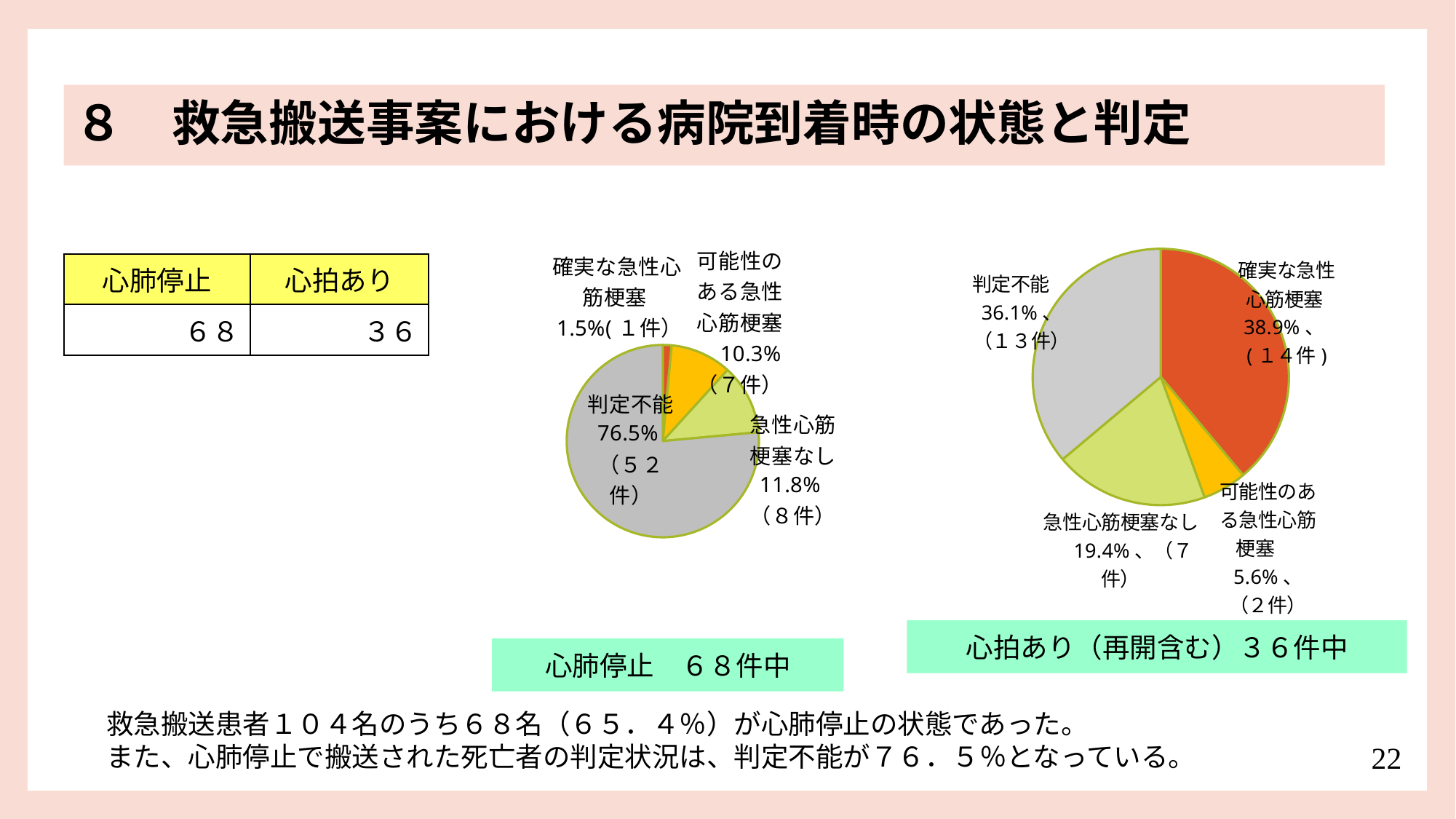
How many slices does the left pie chart (心肺停止 68件中) have? 4 What type of chart is used for 心拍あり（再開含む）36件中? Pie chart In the right pie chart (心拍あり（再開含む）36件中), which category has the largest slice? 確実な急性心筋梗塞 In the left pie chart (心肺停止 68件中), what percentage is labelled for 判定不能? 76.5% In the left pie chart (心肺停止 68件中), what is the difference in cases between 急性心筋梗塞なし and 可能性のある急性心筋梗塞? 1件 In the right pie chart (心拍あり（再開含む）36件中), which category has the smallest slice? 可能性のある急性心筋梗塞 In the right pie chart (心拍あり（再開含む）36件中), what colour is the 判定不能 slice? Grey In the right pie chart (心拍あり（再開含む）36件中), which is larger: the share for 判定不能 or the share for 急性心筋梗塞なし? 判定不能 In the right pie chart (心拍あり（再開含む）36件中), what percentage is labelled for 確実な急性心筋梗塞? 38.9% In the left pie chart (心肺停止 68件中), which category has the smallest slice? 確実な急性心筋梗塞 In the left pie chart (心肺停止 68件中), how many cases (件) are labelled for 急性心筋梗塞なし? 8件 In the right pie chart (心拍あり（再開含む）36件中), how many cases (件) are labelled for 判定不能? 13件